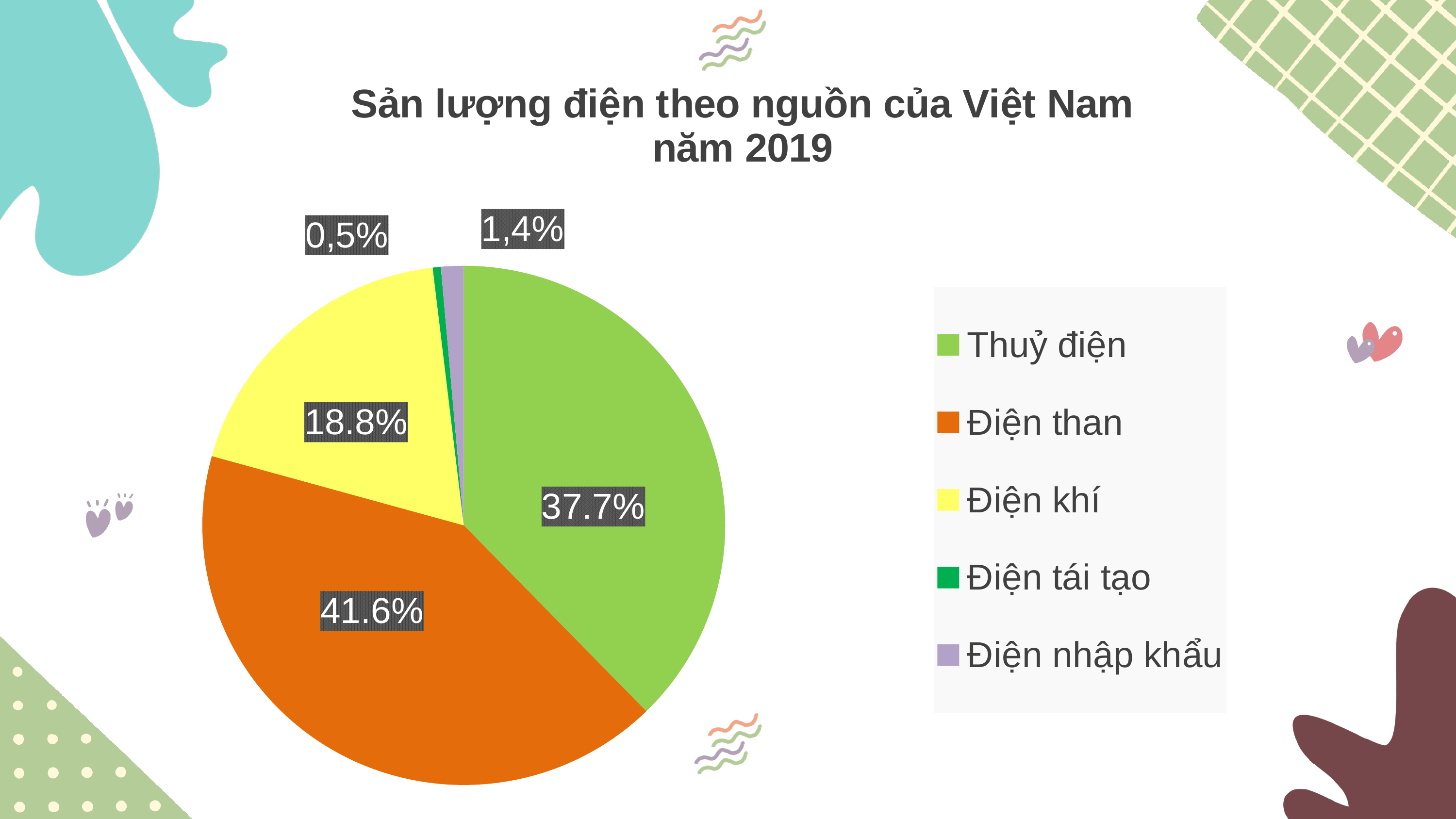
What is the difference between the share for Điện than and the share for Thuỷ điện? 3.9% What share of the pie does Điện nhập khẩu have? 1,4% Which source has the smallest share of the pie? Điện tái tạo What share of the pie does Điện than have? 41.6% What is the title of the chart? Sản lượng điện theo nguồn của Việt Nam năm 2019 Which source has the largest share of the pie? Điện than What share of the pie does Điện khí have? 18.8% Which is larger, the share for Thuỷ điện or the share for Điện khí? Thuỷ điện How many categories does the legend list? 5 What kind of chart is shown on the slide? pie chart